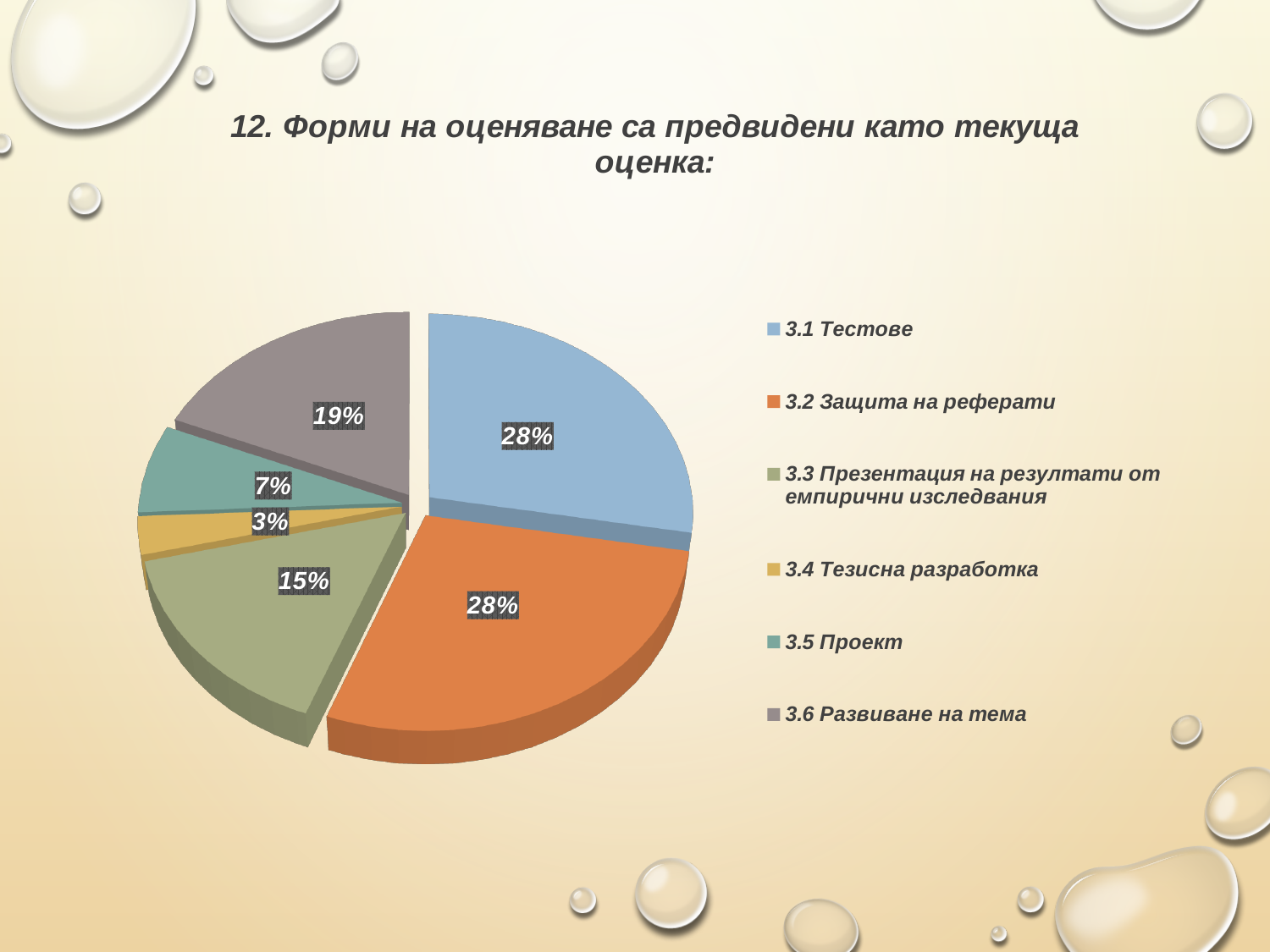
Which category has the smallest slice of the pie? 3.4 Тезисна разработка What kind of chart is shown on the slide? Pie chart What colour is the slice for 3.2 Защита на реферати? Orange What share of the pie does 3.6 Развиване на тема have? 19% How many categories does the pie chart show? 6 What share of the pie does 3.4 Тезисна разработка have? 3% What share of the pie does 3.5 Проект have? 7% What is the difference in percentage points between the slice for 3.6 Развиване на тема and the slice for 3.4 Тезисна разработка? 16 What share of the pie does 3.3 Презентация на резултати от емпирични изследвания have? 15% What share of the pie does 3.1 Тестове have? 28% Which is larger, the slice for 3.6 Развиване на тема or the slice for 3.3 Презентация на резултати от емпирични изследвания? 3.6 Развиване на тема What is the difference in percentage points between the slice for 3.2 Защита на реферати and the slice for 3.5 Проект? 21